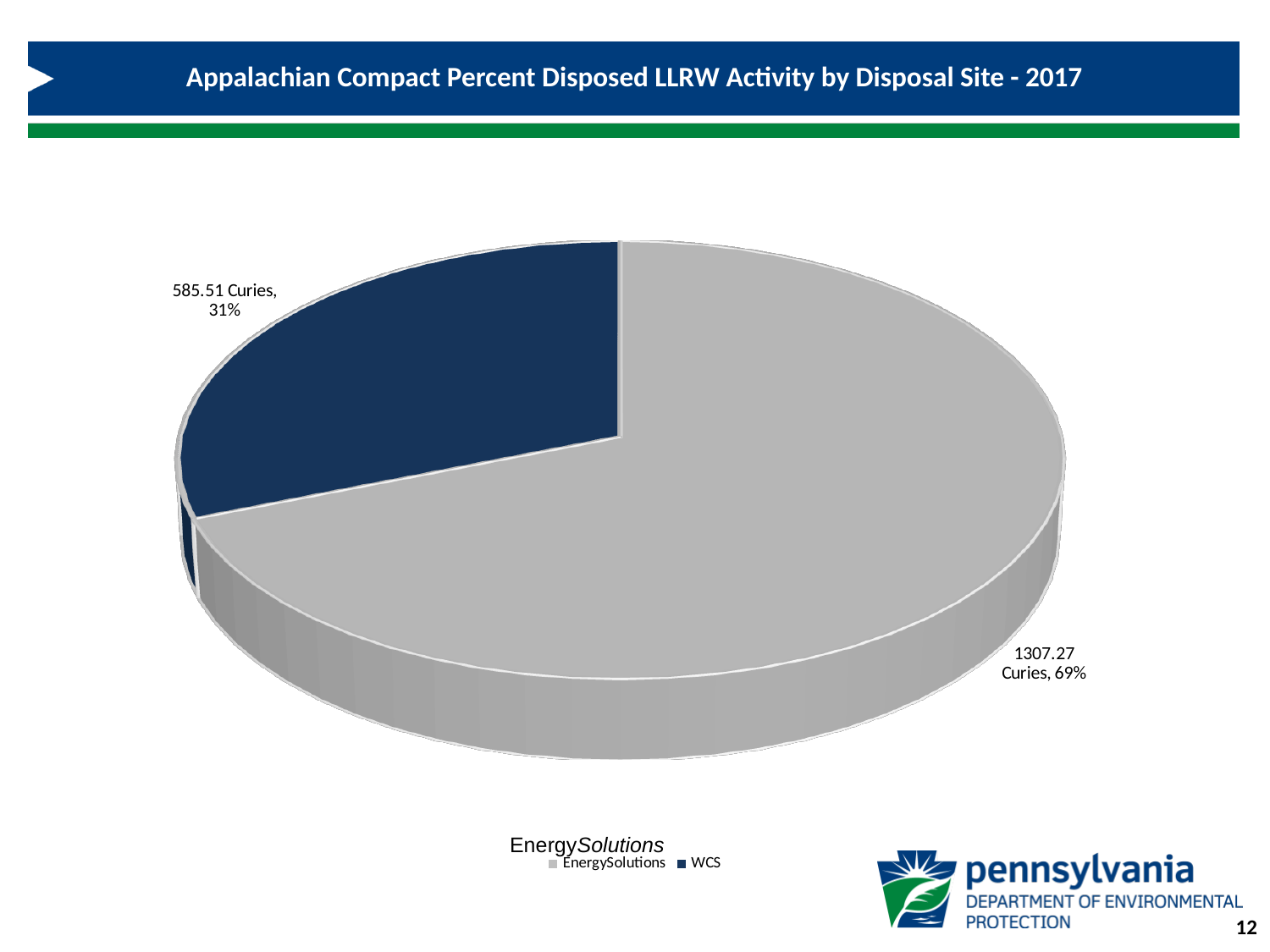
Which disposal site received more curies, EnergySolutions or WCS? EnergySolutions What is the difference in curies between EnergySolutions and WCS? 721.76 Curies How many curies were disposed at WCS? 585.51 Curies How many curies were disposed at EnergySolutions? 1307.27 Curies What percentage of disposed LLRW activity went to WCS? 31% What percentage of disposed LLRW activity went to EnergySolutions? 69% Which disposal site received the largest share of disposed LLRW activity? EnergySolutions What is the title of the chart? Appalachian Compact Percent Disposed LLRW Activity by Disposal Site - 2017 Which disposal site received the smallest share of disposed LLRW activity? WCS How many entries does the legend list? 2 How many disposal sites are shown in the pie chart? 2 What kind of chart is shown on the slide? pie chart